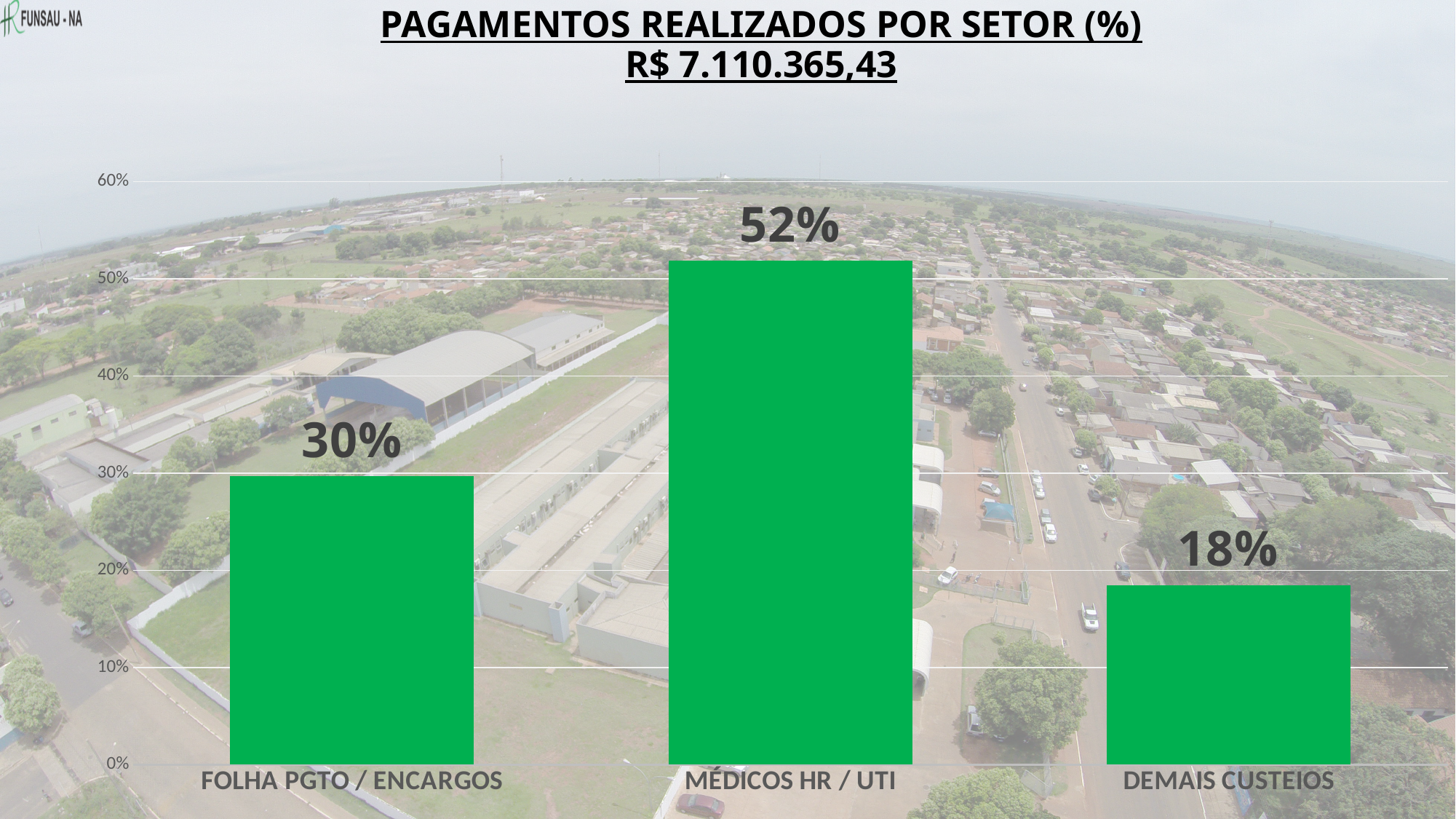
What is the difference between the values for FOLHA PGTO / ENCARGOS and DEMAIS CUSTEIOS? 12% What is the value for DEMAIS CUSTEIOS? 18% What kind of chart is shown on the slide? bar chart What is the value for MÉDICOS HR / UTI? 52% What total amount is shown in the chart title? R$ 7.110.365,43 How many categories are shown in the chart? 3 What is the difference between the values for MÉDICOS HR / UTI and FOLHA PGTO / ENCARGOS? 22% Is the value for MÉDICOS HR / UTI greater or less than 50%? greater Which category has the lowest value? DEMAIS CUSTEIOS What is the value for FOLHA PGTO / ENCARGOS? 30% Which is larger, the value for FOLHA PGTO / ENCARGOS or the value for DEMAIS CUSTEIOS? FOLHA PGTO / ENCARGOS Which category has the highest value? MÉDICOS HR / UTI